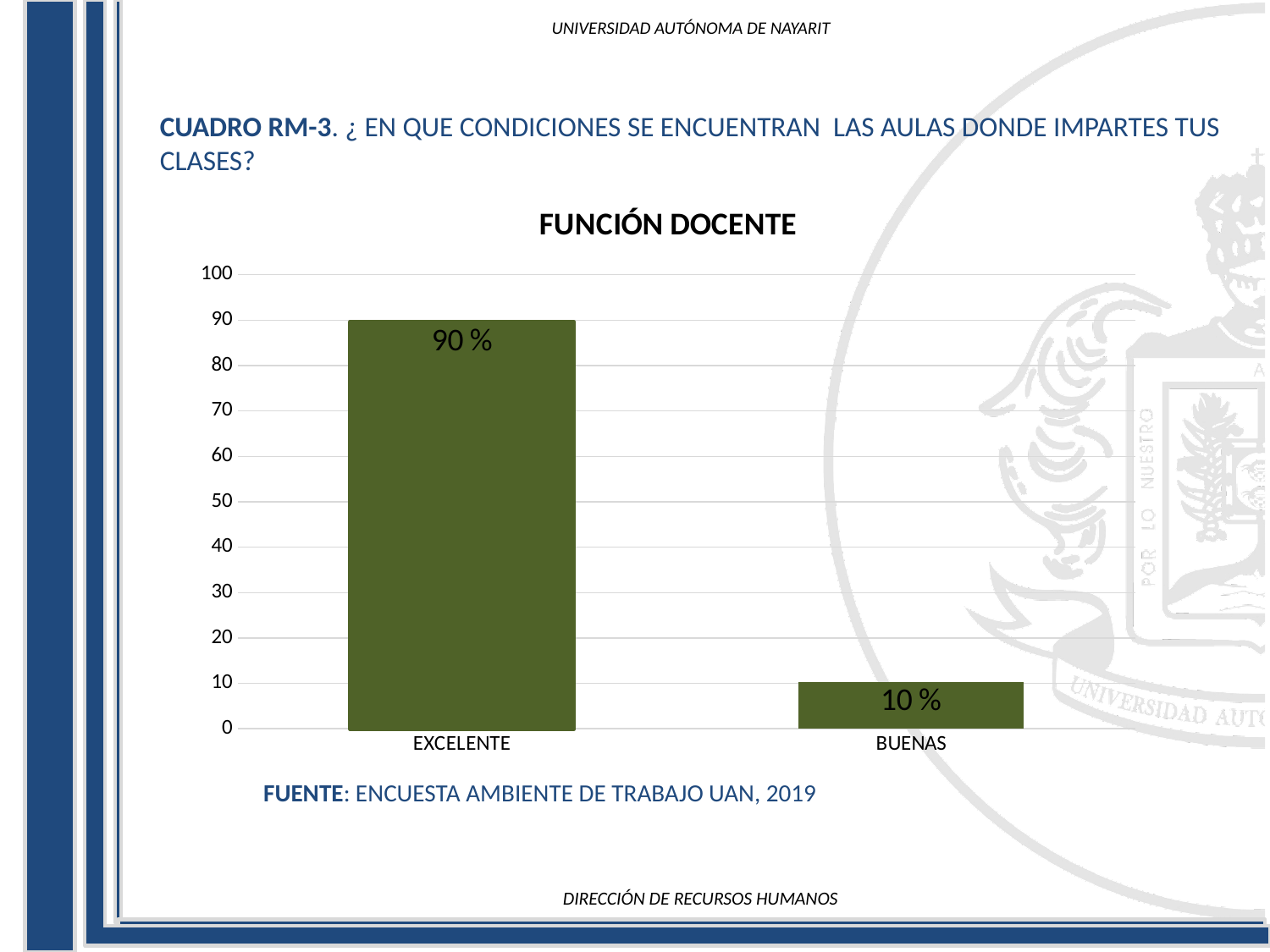
Which category has the highest value? EXCELENTE What kind of chart is shown on the slide? bar chart Which category has the lowest value? BUENAS What is the difference between the values for EXCELENTE and BUENAS? 80 % What is the maximum value shown on the y axis? 100 What is the value for EXCELENTE? 90 % What is the title of the chart? FUNCIÓN DOCENTE Is the value for EXCELENTE greater or less than 50? greater Is the value for BUENAS greater or less than 20? less How many categories are shown on the x axis? 2 Which is larger, the value for EXCELENTE or the value for BUENAS? EXCELENTE What is the value for BUENAS? 10 %